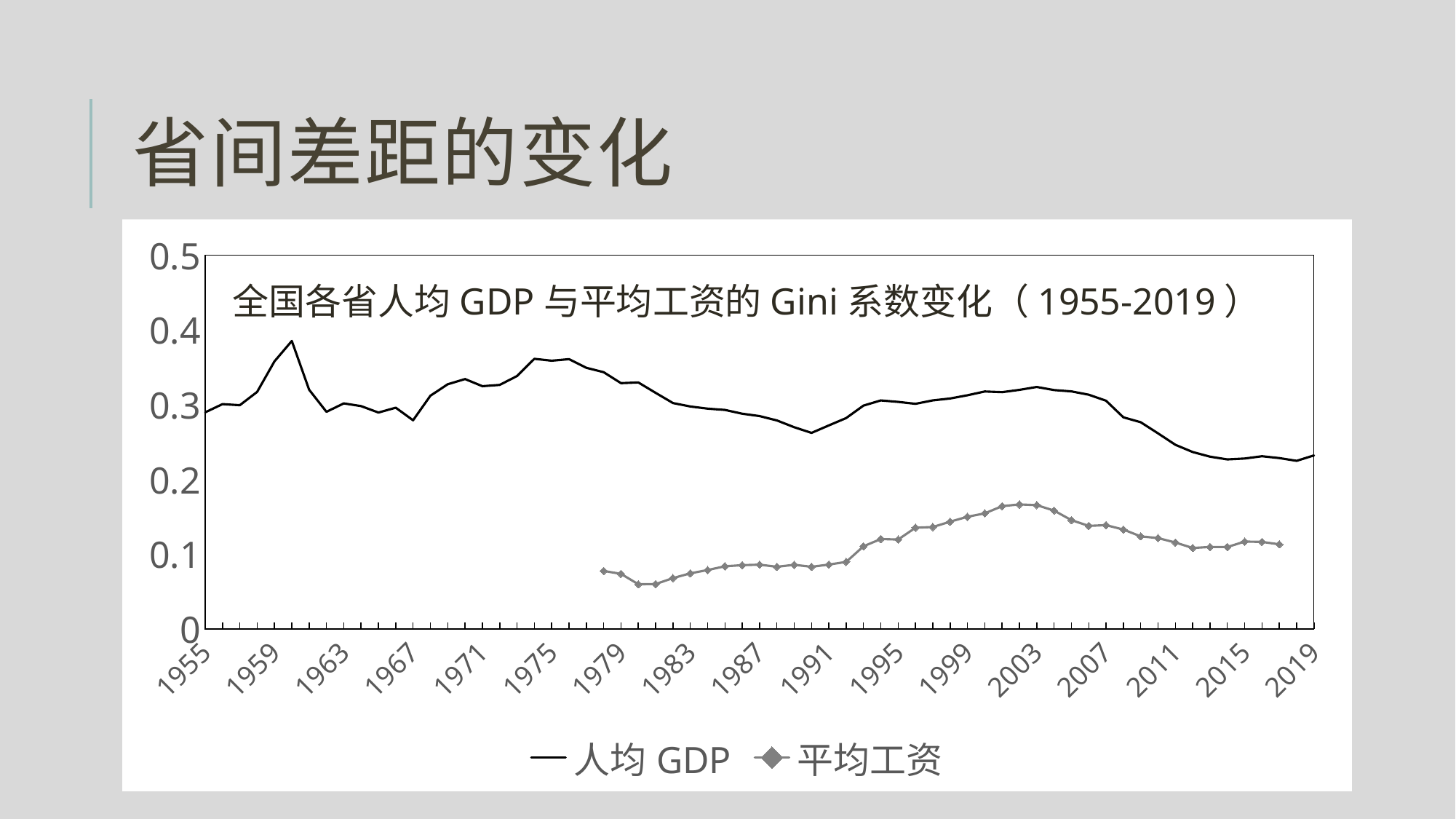
Is the value for 人均 GDP in 1955 greater or less than 0.2? greater What are the two series named in the legend? 人均 GDP and 平均工资 How many series does the legend list? 2 Is the value for 平均工资 in 1983 greater or less than 0.1? less What is the title of the chart? 全国各省人均 GDP 与平均工资的 Gini 系数变化（1955-2019） In 2003, which series has the higher value, 人均 GDP or 平均工资? 人均 GDP Does the 平均工资 line rise or fall between 1983 and 2003? rise Does the 人均 GDP line rise or fall between 2003 and 2019? fall Is the value for 人均 GDP in 2019 greater or less than 0.3? less Which series stays higher across the whole period shown? 人均 GDP What kind of chart is shown on the slide? line chart